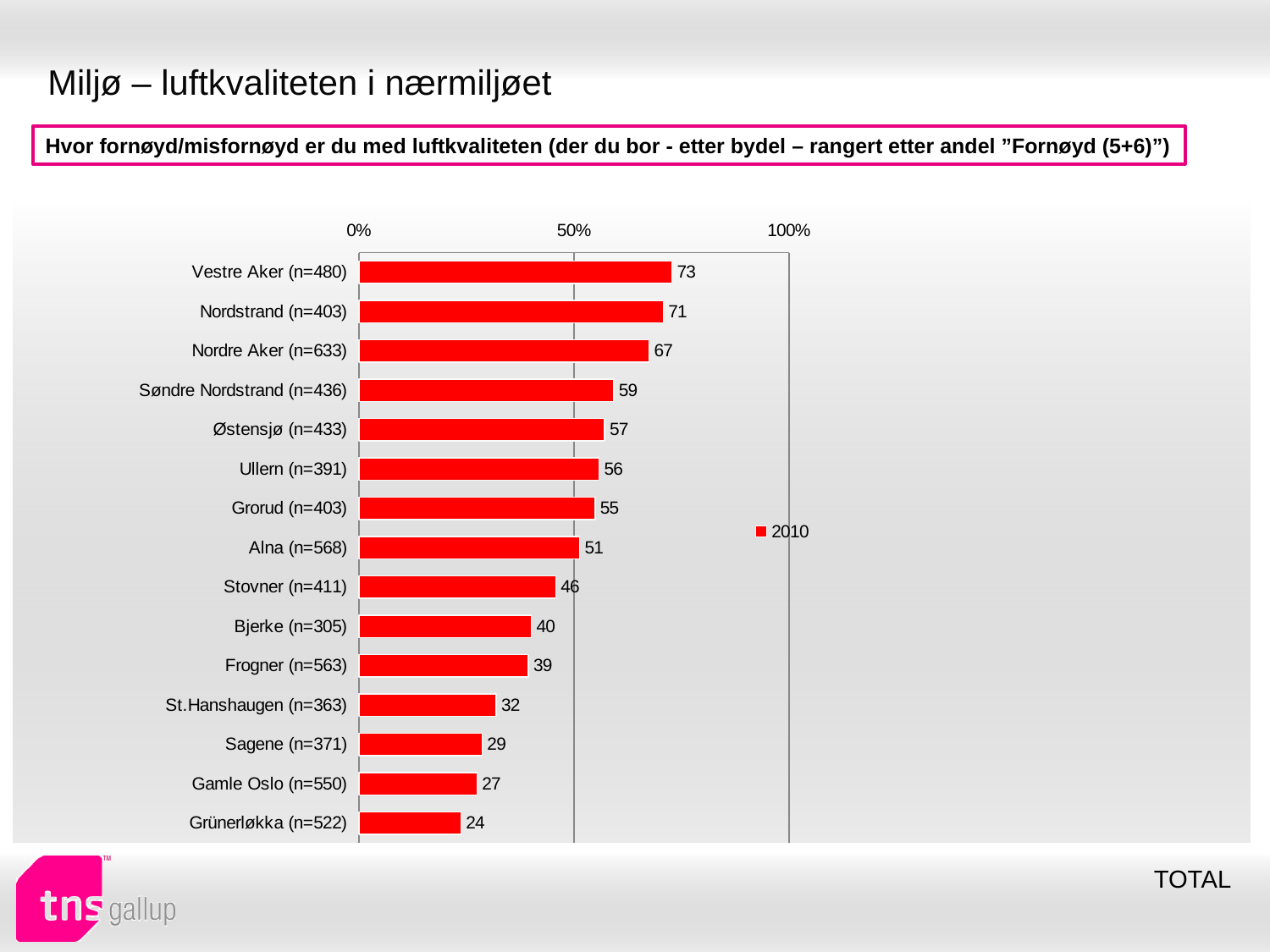
What is the value for Vestre Aker (n=480)? 73 Is the value for Stovner (n=411) greater or less than 50%? less Which bydel has the lowest value? Grünerløkka (n=522) How many series does the legend list? 1 What is the value for Sagene (n=371)? 29 What kind of chart is shown on the slide? bar chart Which is larger, the value for Alna (n=568) or the value for Bjerke (n=305)? Alna (n=568) How many bydeler are shown in the chart? 15 What year does the legend entry show? 2010 What is the difference between the values for Nordstrand (n=403) and Frogner (n=563)? 32 What is the value for Grorud (n=403)? 55 Which bydel has the highest value? Vestre Aker (n=480)